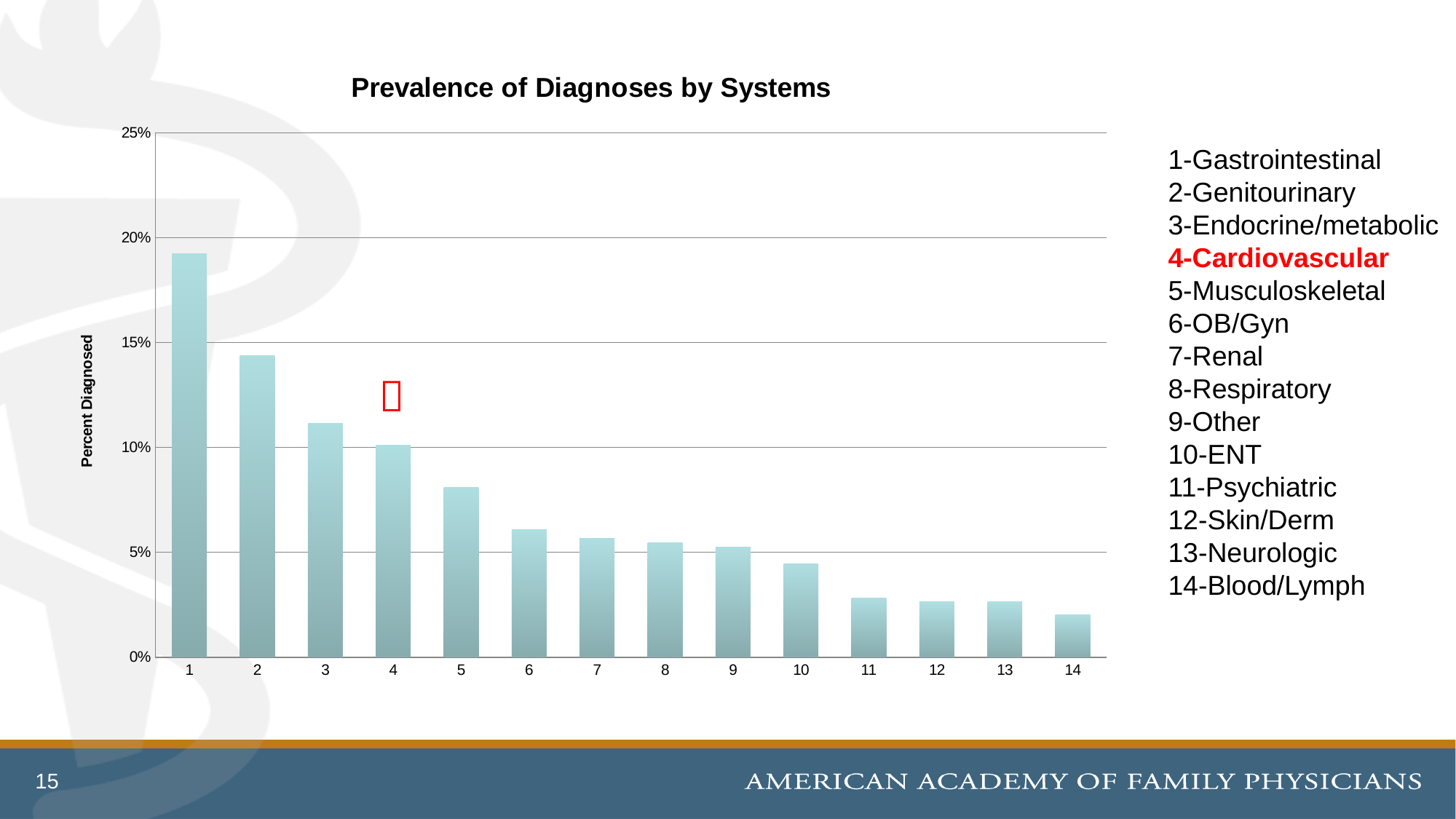
Which category has the lowest percent diagnosed? 14 (Blood/Lymph) Which has a higher percent diagnosed, category 2 (Genitourinary) or category 3 (Endocrine/metabolic)? 2 (Genitourinary) Which category has the highest percent diagnosed? 1 (Gastrointestinal) What is the title of the chart? Prevalence of Diagnoses by Systems Is the value for category 5 (Musculoskeletal) greater or less than 10%? less How many categories (bars) are plotted in the chart? 14 Is the value for category 2 (Genitourinary) greater or less than 15%? less Is the value for category 10 (ENT) greater or less than 5%? less Which system in the legend list is highlighted in red? 4-Cardiovascular What type of chart is shown on the slide? Bar chart Do the values rise or fall moving from category 1 to category 14 along the x axis? Fall